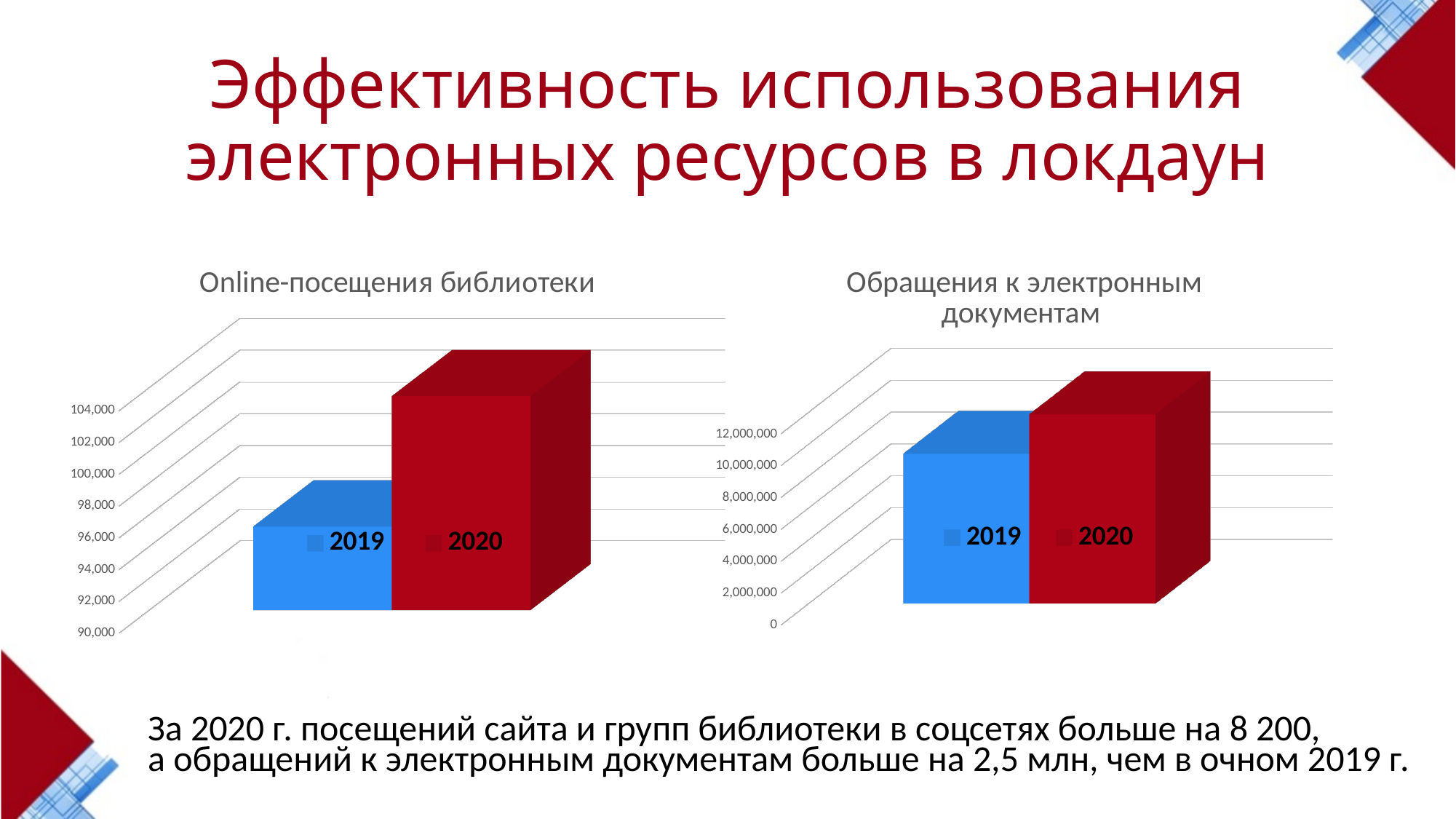
In the 'Обращения к электронным документам' chart, do the values rise or fall from 2019 to 2020? rise In the 'Online-посещения библиотеки' chart, which year has the lower value? 2019 In the 'Online-посещения библиотеки' chart, what colour is the bar for 2020? red How many bars are plotted in the 'Обращения к электронным документам' chart? 2 In the 'Обращения к электронным документам' chart, is the value for 2020 greater or less than 8,000,000? greater In the 'Обращения к электронным документам' chart, is the value for 2019 greater or less than 6,000,000? greater How many series does the legend of the 'Online-посещения библиотеки' chart list? 2 In the 'Online-посещения библиотеки' chart, which year has the higher value? 2020 In the 'Online-посещения библиотеки' chart, is the value for 2019 greater or less than 100,000? less What kind of chart is the 'Online-посещения библиотеки' chart? bar chart In the 'Обращения к электронным документам' chart, which year has the higher value? 2020